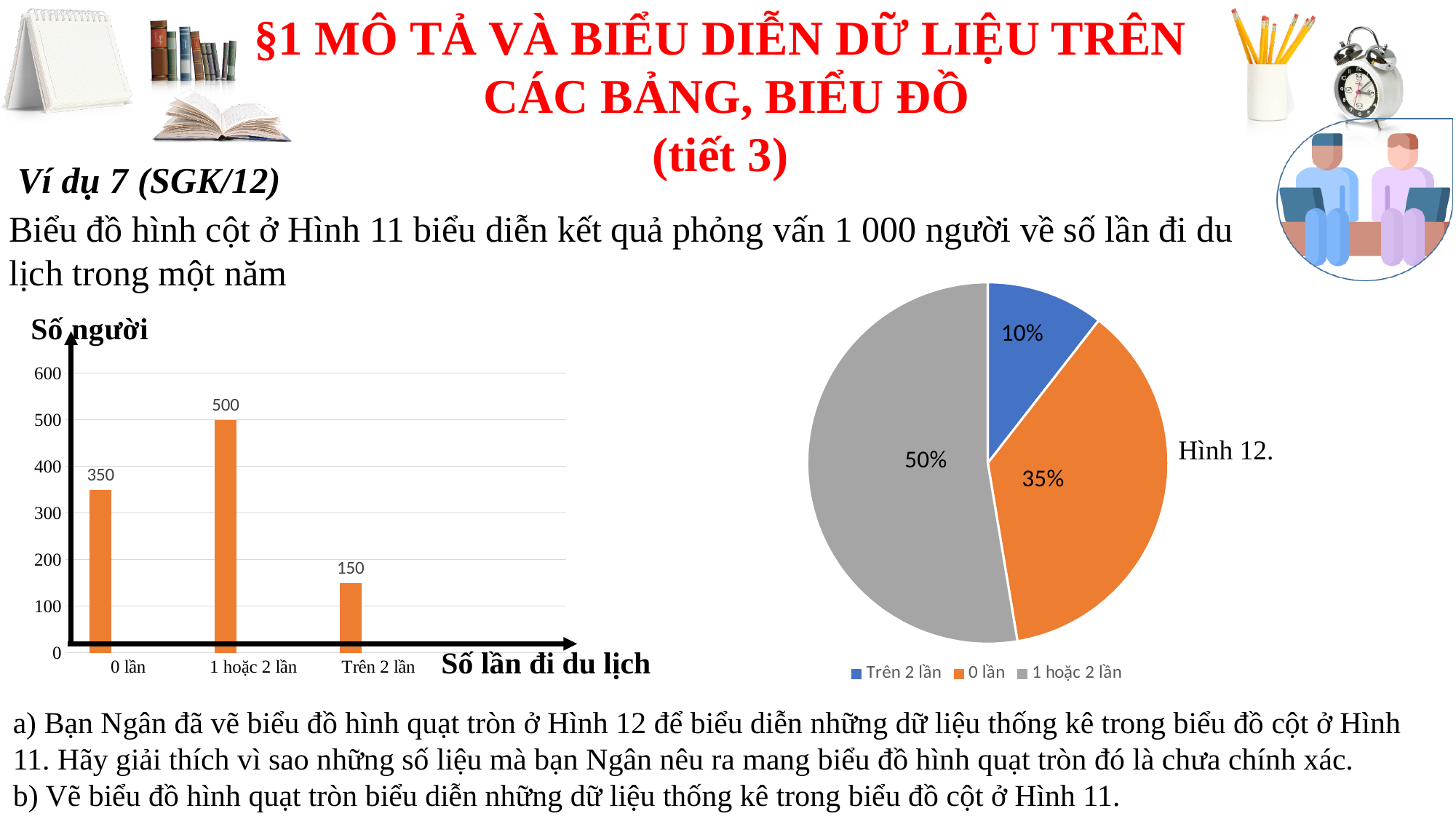
In the pie chart on the right (Hình 12), what colour is the '1 hoặc 2 lần' slice? gray In the pie chart on the right (Hình 12), which slice is the largest? 1 hoặc 2 lần How many entries does the legend of the pie chart on the right list? 3 In the bar chart on the left, what is the value for '1 hoặc 2 lần'? 500 In the bar chart on the left, what is the difference between the values for '1 hoặc 2 lần' and 'Trên 2 lần'? 350 In the bar chart on the left, what is the value for '0 lần'? 350 What kind of chart is the chart on the left? bar chart In the pie chart on the right (Hình 12), what share is shown for 'Trên 2 lần'? 10% In the bar chart on the left, how many categories are shown on the x axis? 3 In the pie chart on the right (Hình 12), what share is shown for '0 lần'? 35% In the bar chart on the left, which category has the lowest value? Trên 2 lần In the bar chart on the left, which category has the highest value? 1 hoặc 2 lần